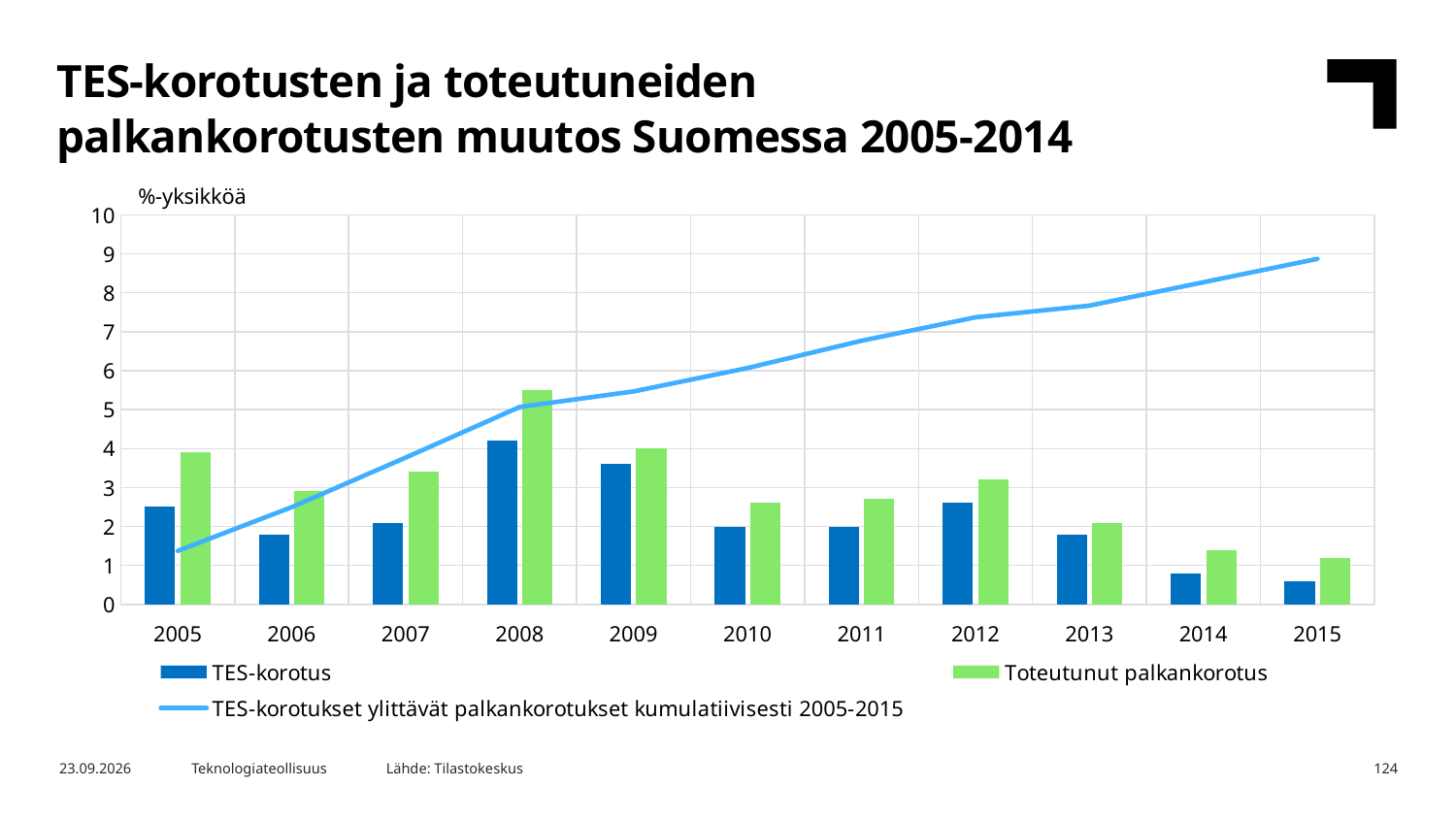
Which is larger in 2008, the TES-korotus bar or the Toteutunut palkankorotus bar? Toteutunut palkankorotus How many series does the legend list? 3 What kind of chart is shown on the slide? A combined bar and line chart How many years are shown on the x axis? 11 Is the 2015 value of the line 'TES-korotukset ylittävät palkankorotukset kumulatiivisesti 2005-2015' greater or less than 8? greater In which year is the Toteutunut palkankorotus bar lowest? 2015 In which year is the TES-korotus bar highest? 2008 Does the line 'TES-korotukset ylittävät palkankorotukset kumulatiivisesti 2005-2015' rise or fall from 2005 to 2015? It rises Is the Toteutunut palkankorotus value for 2008 greater or less than 5? greater Is the TES-korotus value for 2008 greater or less than 4? greater In which year is the Toteutunut palkankorotus bar highest? 2008